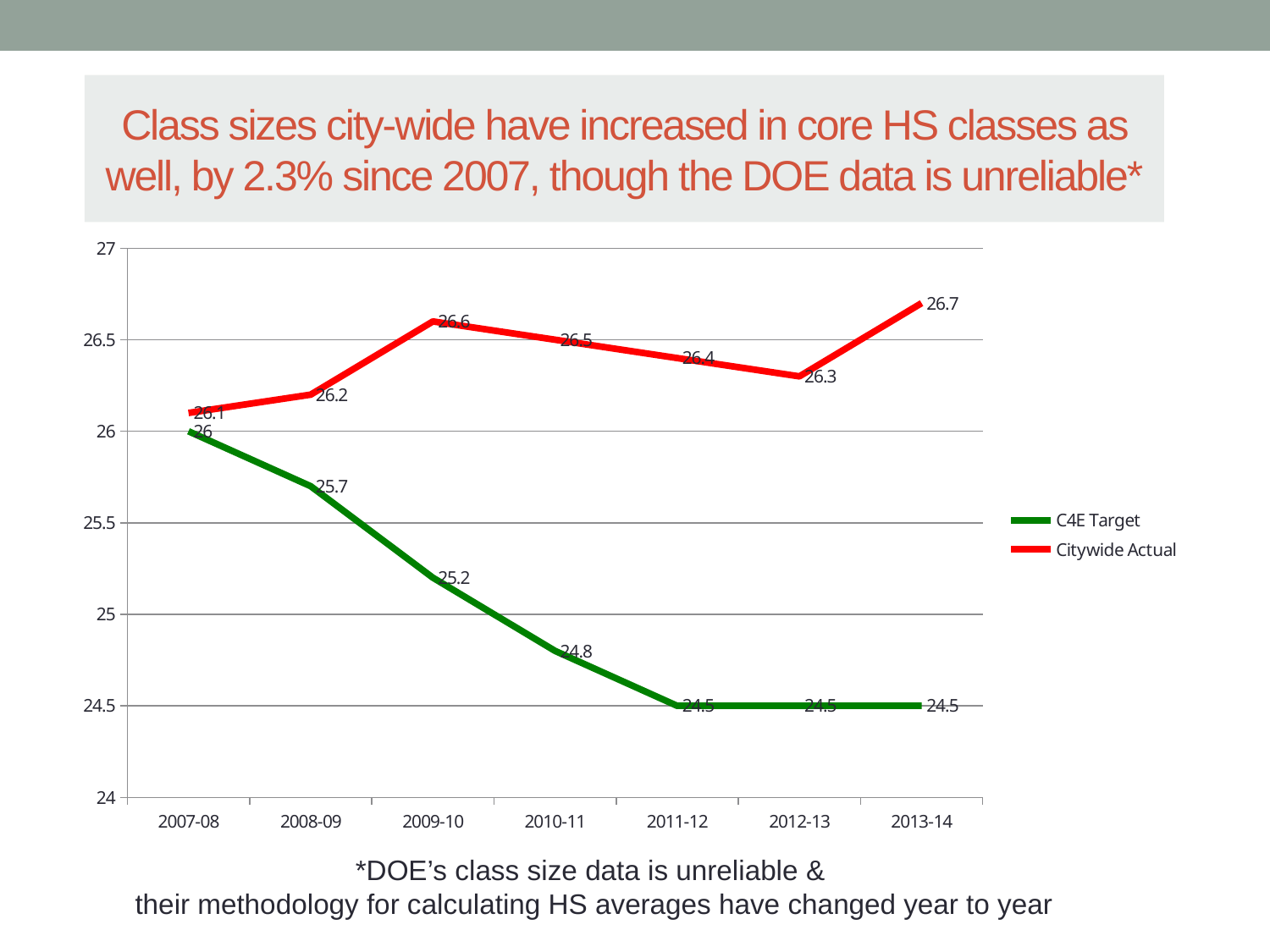
What kind of chart is shown on the slide? Line chart In which year is the C4E Target value highest? 2007-08 What is the Citywide Actual value for 2013-14? 26.7 What is the C4E Target value for 2009-10? 25.2 What is the difference between the Citywide Actual and C4E Target values in 2013-14? 2.2 How many series does the legend list? 2 In which year is the Citywide Actual value highest? 2013-14 What colour is the line for Citywide Actual? Red Does the C4E Target series rise or fall from 2007-08 to 2011-12? Fall What is the Citywide Actual value for 2007-08? 26.1 Which is larger in 2010-11, the Citywide Actual value or the C4E Target value? Citywide Actual How many years are shown on the x axis? 7